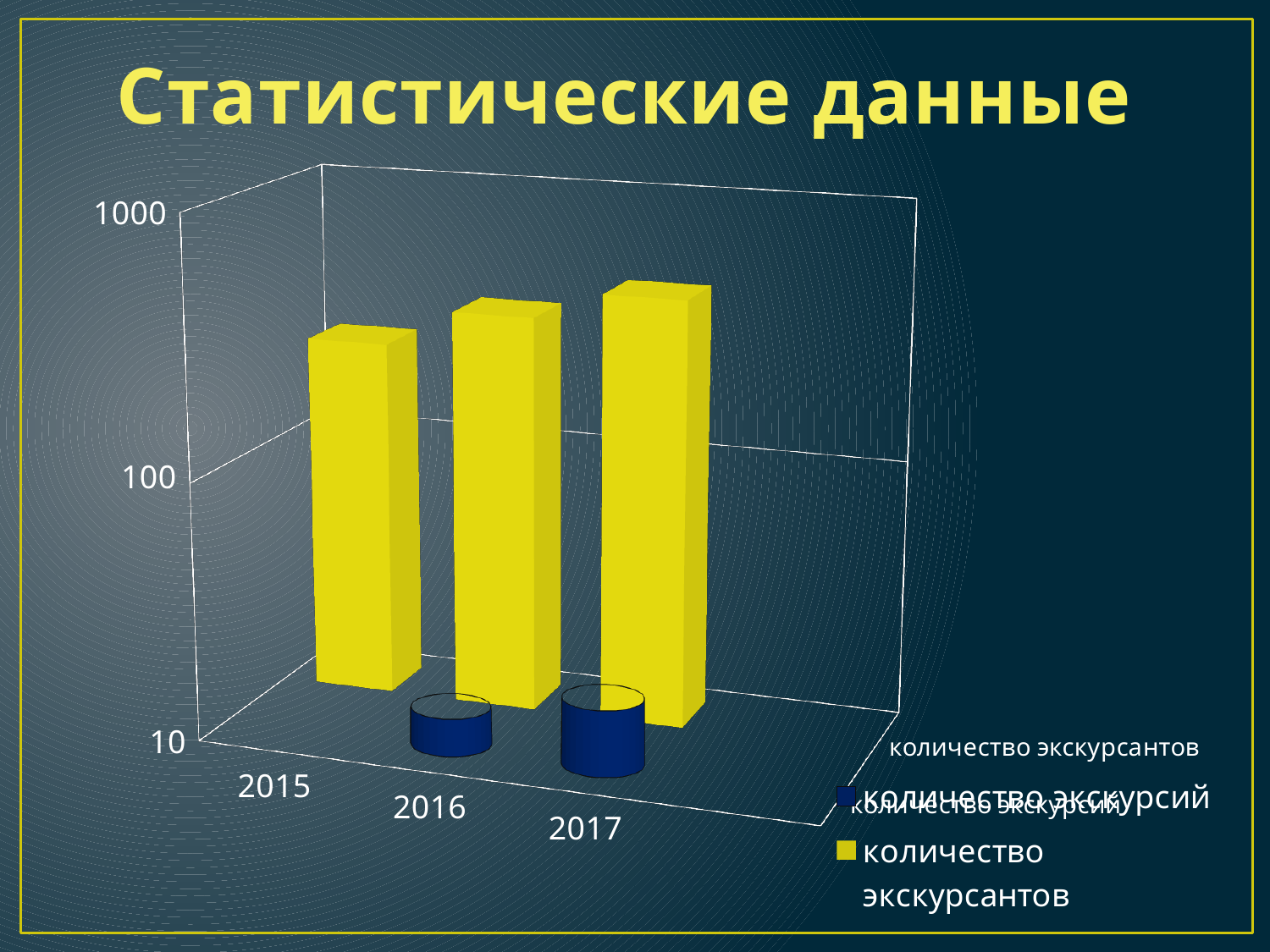
Is the value for количество экскурсий in 2017 greater or less than 100? less Which colour represents количество экскурсантов in the chart? yellow What type of chart is shown on the slide? bar chart How many series does the legend list? 2 Is the value for количество экскурсантов in 2017 greater or less than 100? greater Which year has the lowest value for количество экскурсантов? 2015 What is the title of the slide? Статистические данные Which year has the highest value for количество экскурсантов? 2017 Which is larger: количество экскурсий in 2016 or in 2017? 2017 Does the value for количество экскурсантов rise or fall from 2015 to 2017? rise Which is larger: количество экскурсантов in 2015 or in 2017? 2017 How many years are shown on the x axis? 3